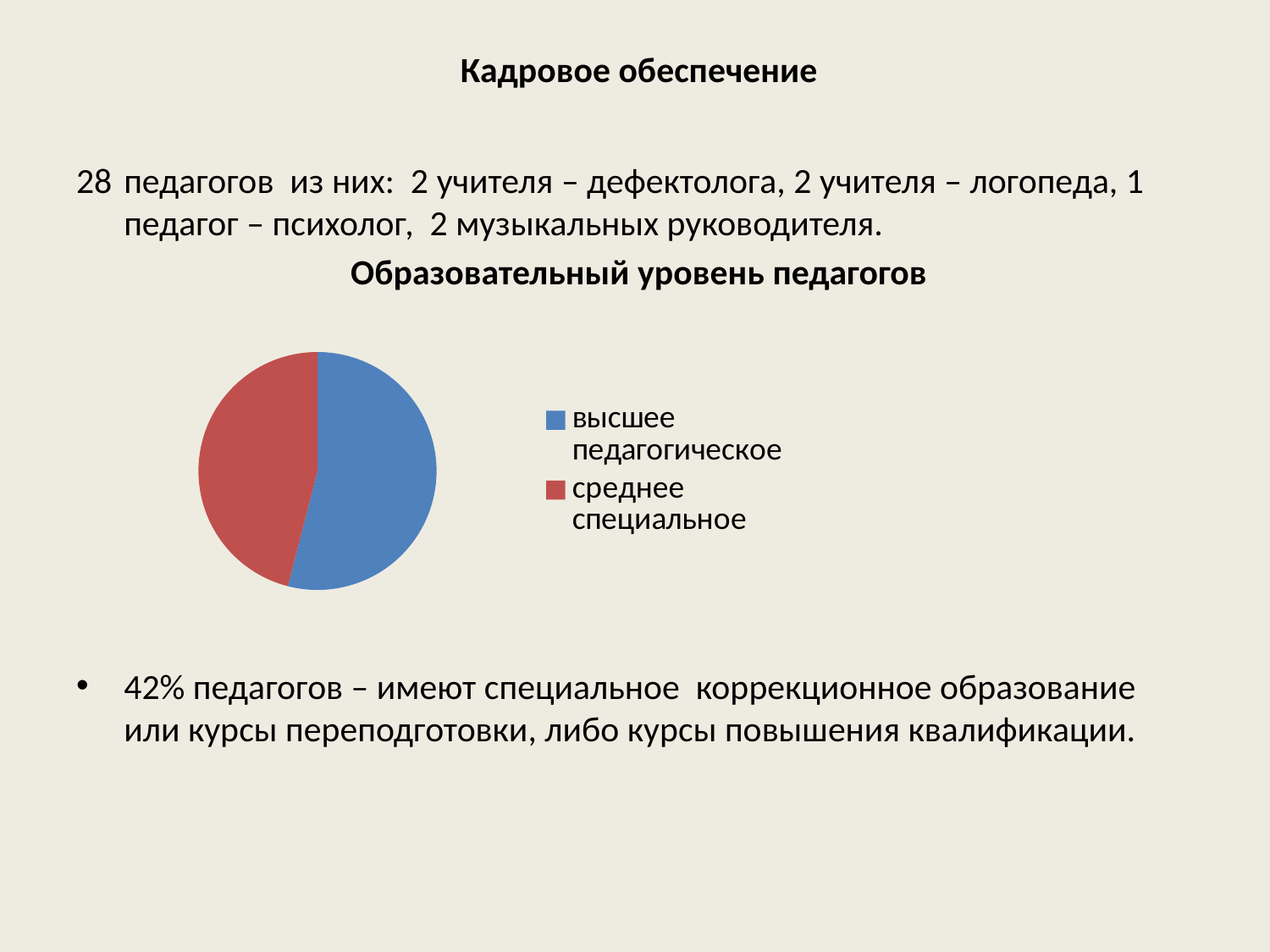
Which category has the larger slice in the pie chart? высшее педагогическое How many entries does the chart legend list? 2 Which slice is larger: "высшее педагогическое" or "среднее специальное"? высшее педагогическое What kind of chart is shown on the slide? pie chart What is the title of the chart? Образовательный уровень педагогов Which category has the smaller slice in the pie chart? среднее специальное Which colour represents "среднее специальное" in the pie chart? red How many slices does the pie chart have? 2